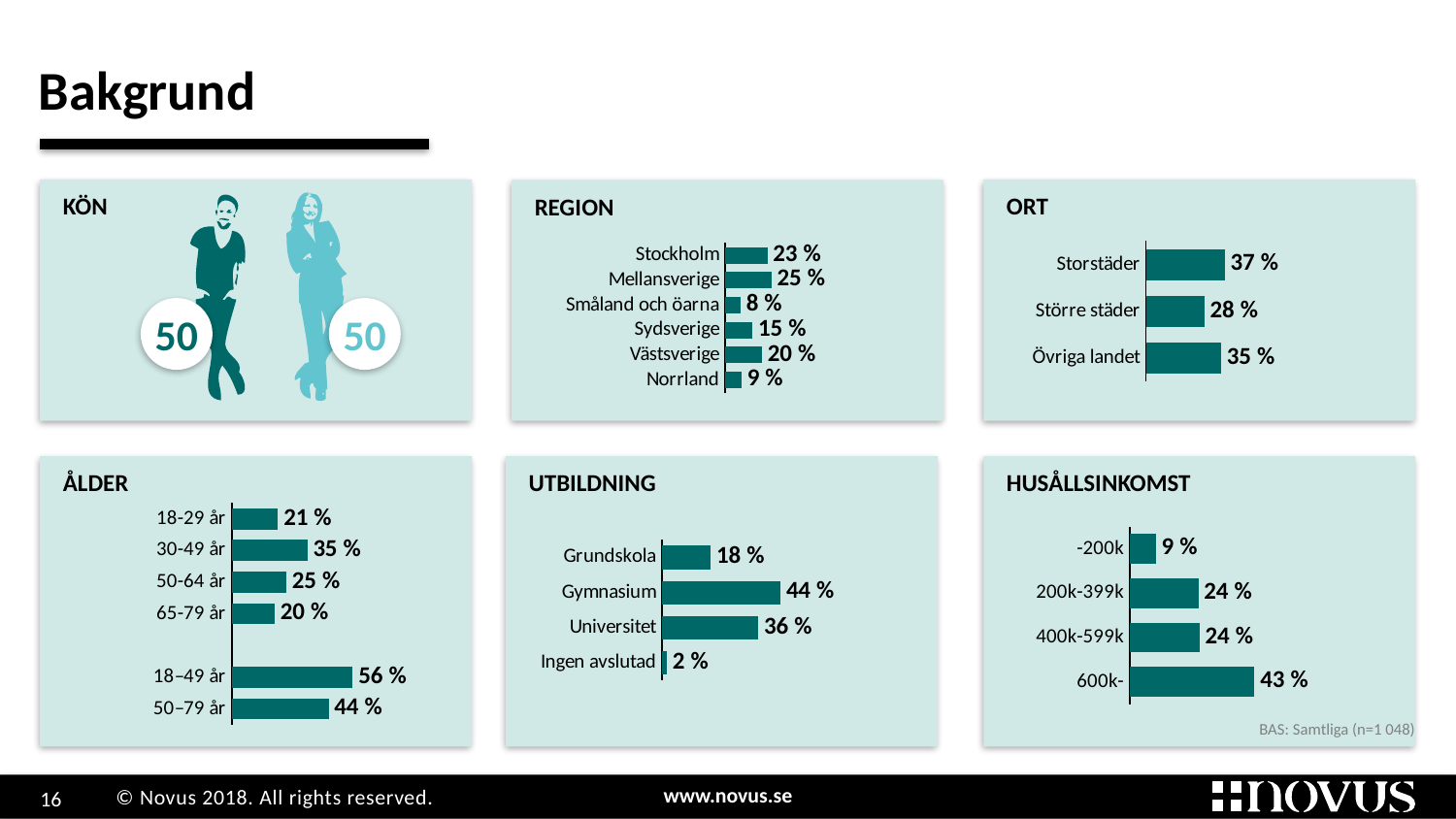
In the HUSÅLLSINKOMST chart, what is the difference between 600k- and -200k? 34 % In the REGION chart, which region has the lowest value? Småland och öarna In the REGION chart, what is the value for Mellansverige? 25 % In the ÅLDER chart, what is the value for 30-49 år? 35 % In the UTBILDNING chart, which category has the highest value? Gymnasium In the ÅLDER chart, which is larger, 18-29 år or 50-64 år? 50-64 år In the HUSÅLLSINKOMST chart, what is the value for 600k-? 43 % In the ORT chart, what is the difference between Storstäder and Större städer? 9 % What kind of chart is the REGION chart? Bar chart In the UTBILDNING chart, how many categories are shown? 4 In the ORT chart, which category has the highest value? Storstäder In the REGION chart, how many regions are listed? 6